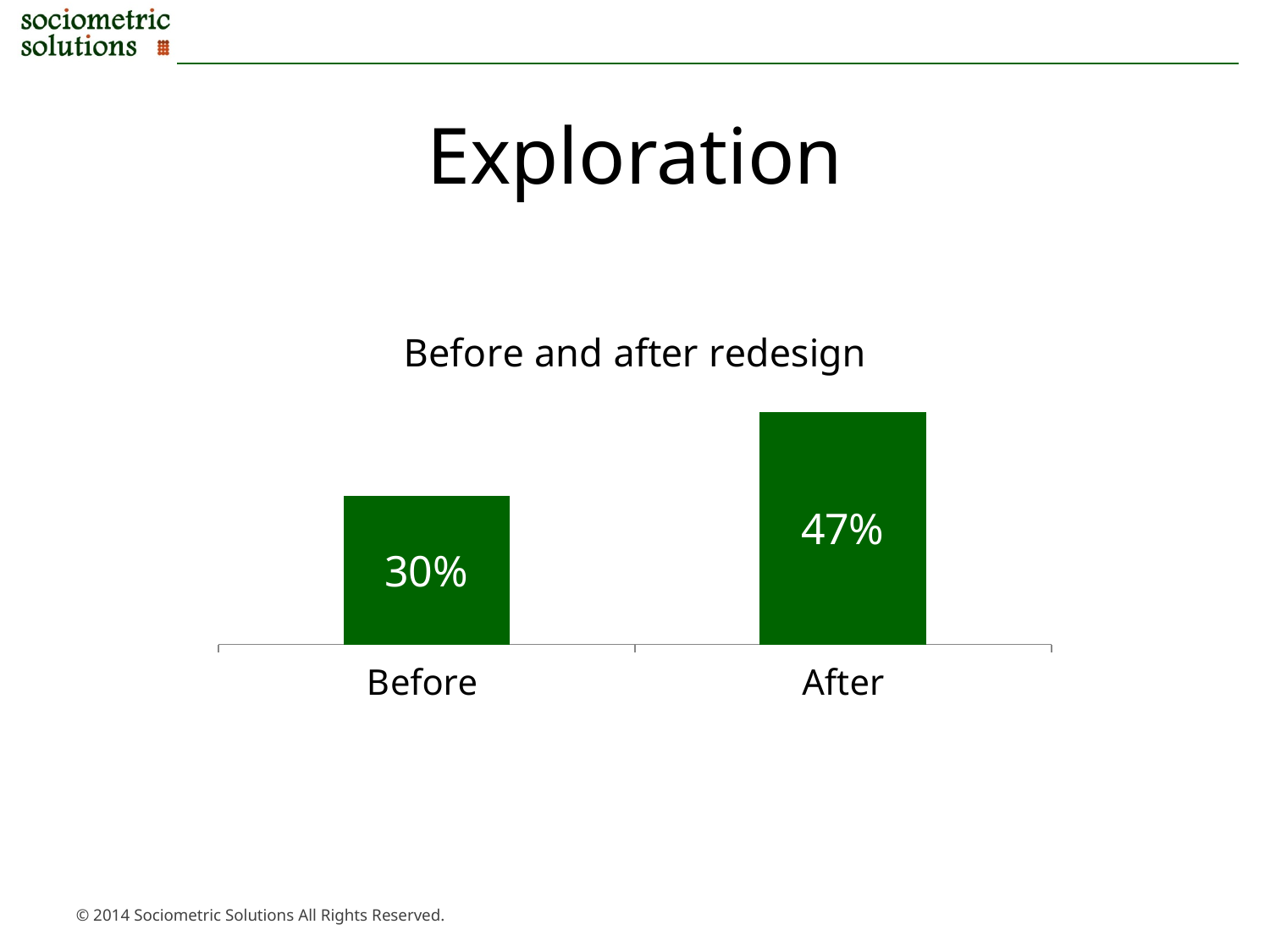
Which category has the lowest value? Before What is the value for Before? 30% What kind of chart is shown on the slide? Bar chart What is the difference between the After and Before values? 17% What colour are the bars in the chart? Green What is the title of the chart? Before and after redesign What is the value for After? 47% Which category has the highest value? After How many categories are shown in the chart? 2 Which is larger, the value for Before or the value for After? After Do the values rise or fall from Before to After? Rise